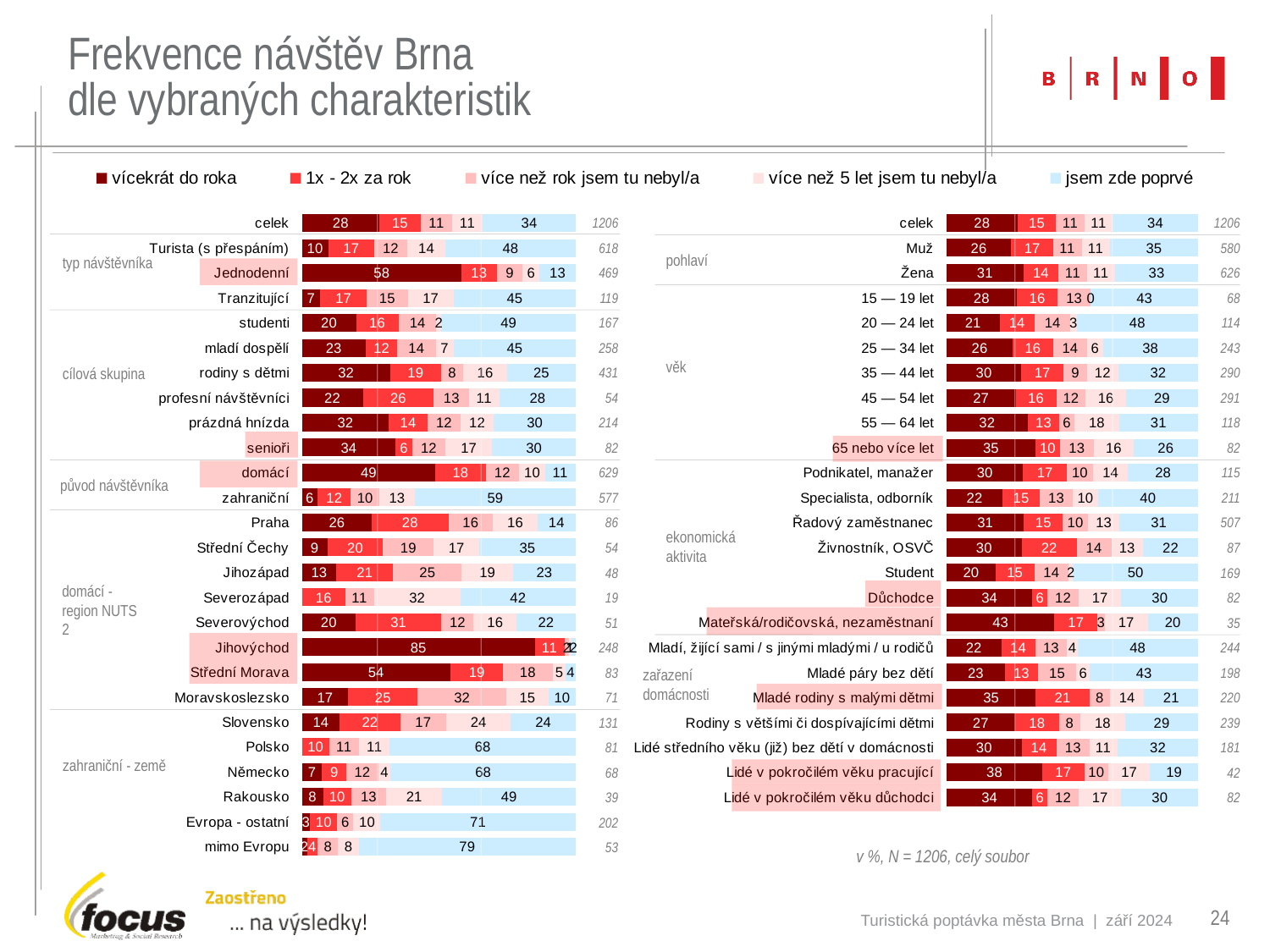
How many series does the legend list? 5 In the left chart, what is the value of '1x - 2x za rok' for 'Praha'? 28 In the right chart, what is the value of 'vícekrát do roka' for 'Muž'? 26 In the right chart, which category has the highest value for 'vícekrát do roka'? Mateřská/rodičovská, nezaměstnaní In the right chart, what is the value of 'jsem zde poprvé' for 'Student'? 50 In the left chart, which category has the highest value for 'jsem zde poprvé'? mimo Evropu In the right chart, which has the larger 'vícekrát do roka' value, 'Muž' or 'Žena'? Žena What kind of chart is used on this slide? bar chart In the right chart, what is the difference between the 'vícekrát do roka' values for 'Žena' and 'Muž'? 5 In the left chart, what is the value of 'jsem zde poprvé' for 'zahraniční'? 59 What is the first entry in the legend? vícekrát do roka In the left chart, what is the value of 'vícekrát do roka' for 'Jihovýchod'? 85